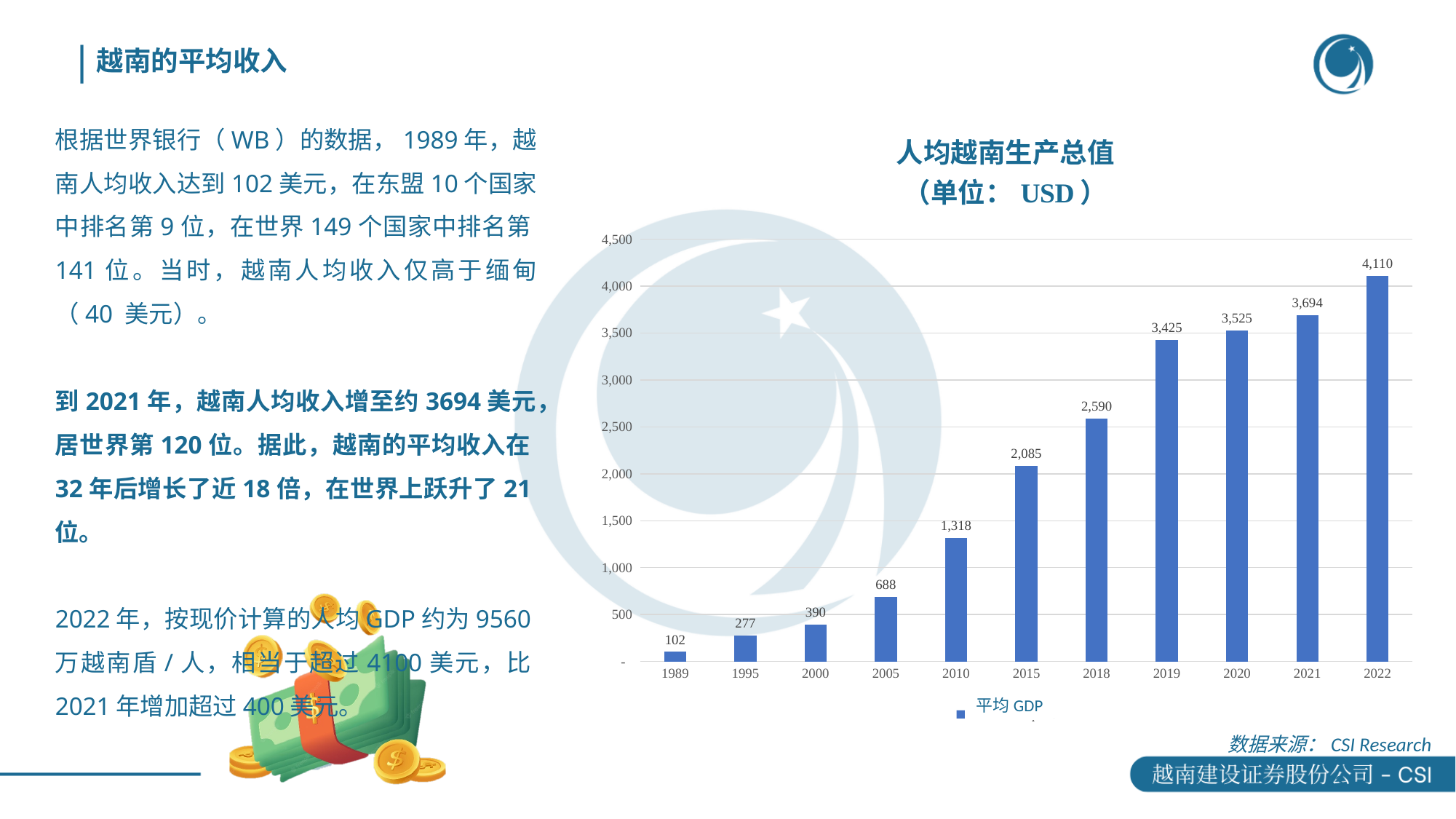
What is the value for 2010? 1,318 What is the value for 1995? 277 What is the value for 2019? 3,425 What is the difference between the values for 2022 and 2021? 416 Which year has the lowest value? 1989 Which is larger, the value for 2015 or the value for 2018? 2018 How many years are shown on the x axis? 11 Is the value for 2020 greater or less than 3,000? greater Do the values rise or fall from 1989 to 2022? rise What kind of chart is shown? bar chart How many series does the legend list? 1 Which year has the highest value? 2022